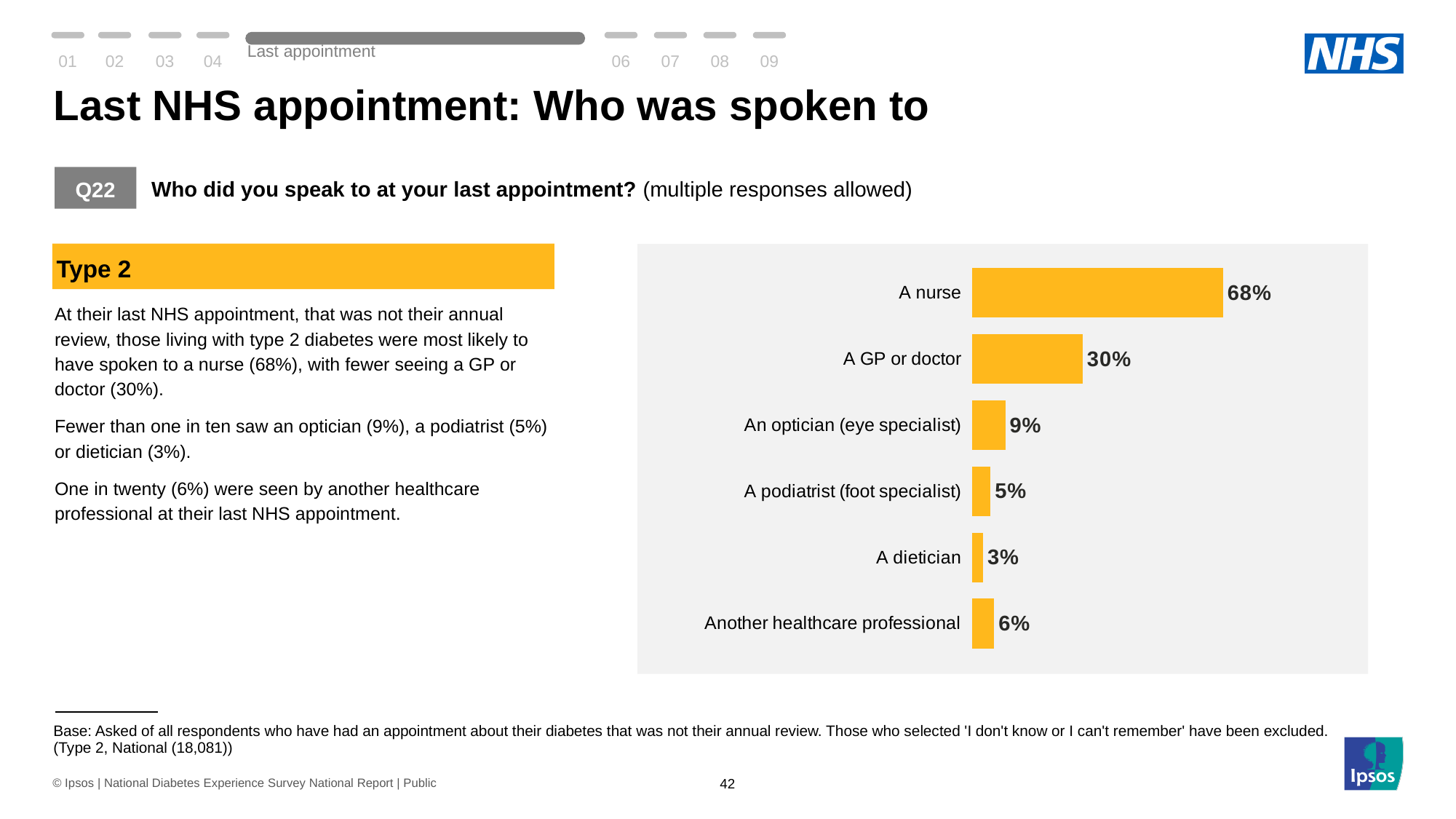
What percentage of respondents spoke to a nurse at their last appointment? 68% How many categories are shown in the chart? 6 What is the difference between the values for 'A nurse' and 'A GP or doctor'? 38 percentage points What is the value for 'Another healthcare professional'? 6% What is the difference between the values for 'An optician (eye specialist)' and 'A dietician'? 6 percentage points What kind of chart is shown on the slide? Bar chart What is the value shown for 'A GP or doctor'? 30% Which is larger: the value for 'A podiatrist (foot specialist)' or 'Another healthcare professional'? Another healthcare professional What colour are the bars in the chart? Yellow/orange Which category has the highest value in the chart? A nurse What percentage spoke to an optician (eye specialist)? 9% Which category has the lowest value in the chart? A dietician